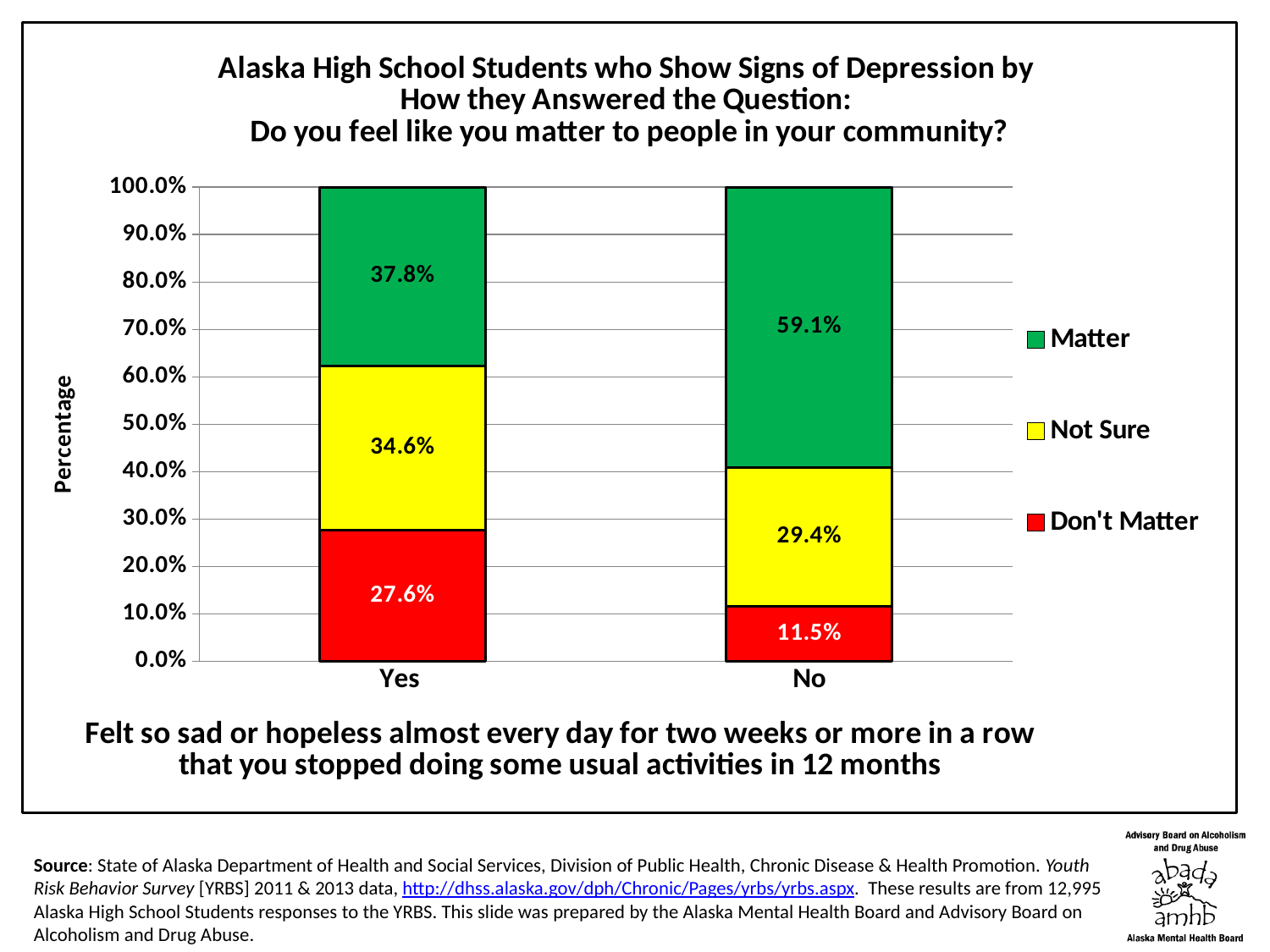
How many series does the legend list? 3 What percentage of the "No" bar is "Don't Matter"? 11.5% What is the difference between the "Don't Matter" values for "Yes" and "No"? 16.1% What kind of chart is shown on the slide? Stacked bar chart How many categories are shown on the x axis? 2 Which category has the lower "Don't Matter" value? No What is the "Not Sure" value for the "No" category? 29.4% What percentage of the "Yes" bar is "Matter"? 37.8% What colour represents the "Not Sure" series? Yellow Which category has the higher "Matter" value, "Yes" or "No"? No What is the "Don't Matter" value for the "Yes" category? 27.6% What is the difference between the "Matter" values for "No" and "Yes"? 21.3%